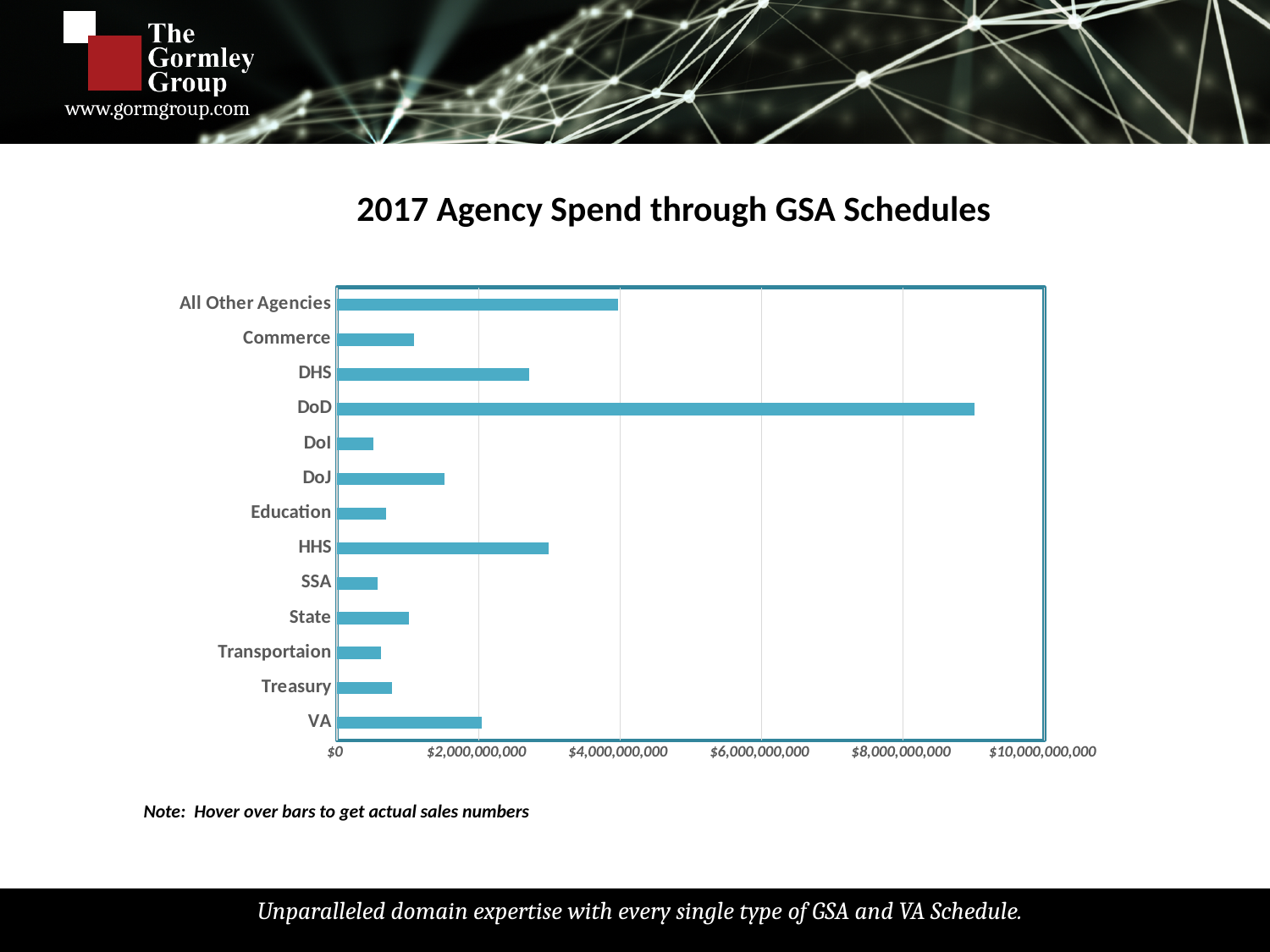
Is the value for DoD greater or less than $8,000,000,000? greater Is the value for DHS greater or less than $2,000,000,000? greater Is the value for HHS greater or less than $2,000,000,000? greater How many agency categories are plotted in the chart? 13 What is the title of the chart? 2017 Agency Spend through GSA Schedules What kind of chart is shown on the slide? Bar chart Which agency has the highest spend through GSA Schedules? DoD Which is larger, the spend for DHS or the spend for Commerce? DHS Which is larger, the spend for All Other Agencies or the spend for HHS? All Other Agencies Which is larger, the spend for DoD or the spend for HHS? DoD